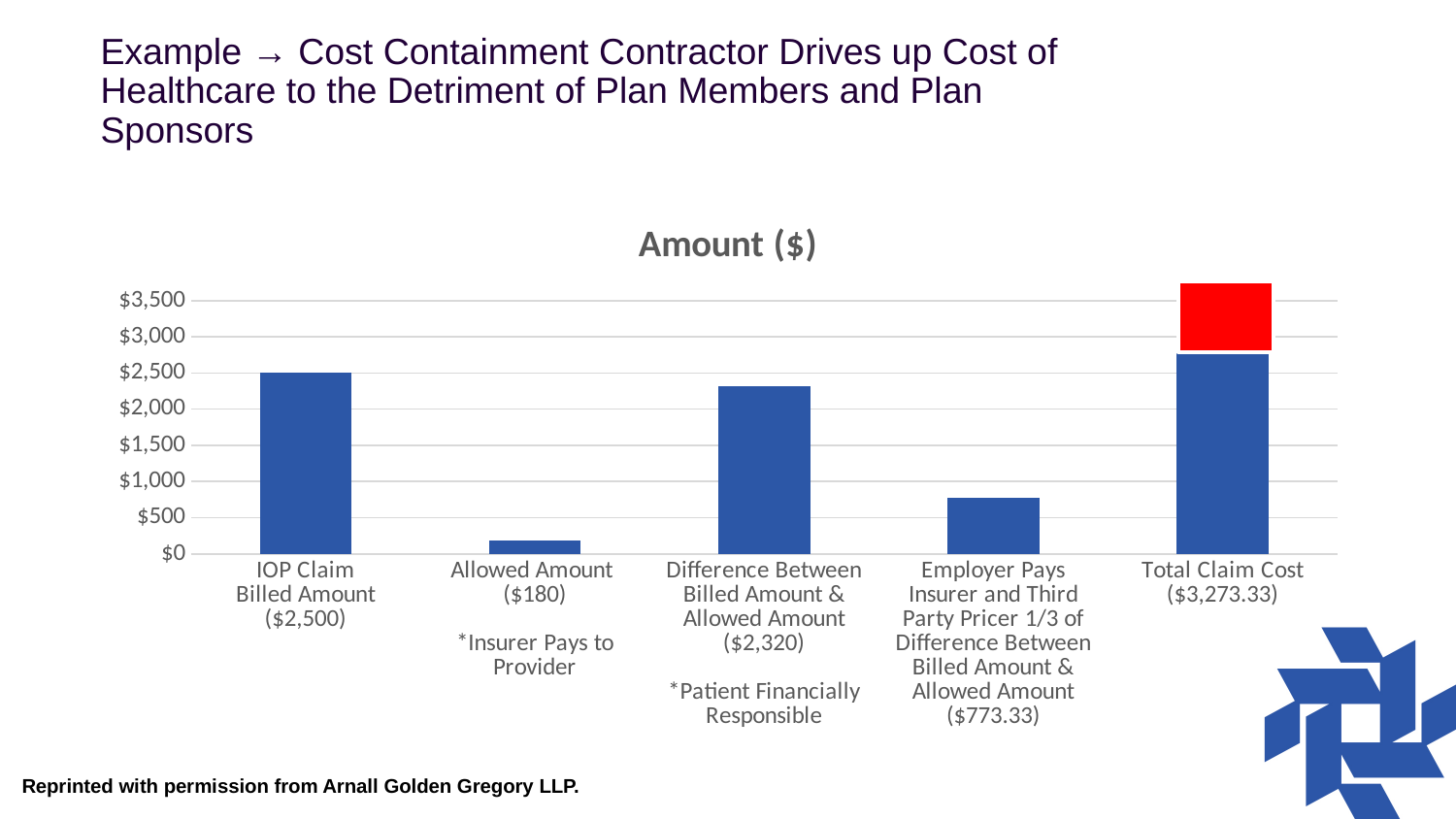
How many categories are shown on the x axis? 5 What is the value for Allowed Amount? $180 What is the value for IOP Claim Billed Amount? $2,500 Which category has the lowest value? Allowed Amount What is the title of the chart? Amount ($) Which category has the highest value? Total Claim Cost What is the difference between IOP Claim Billed Amount and Allowed Amount? $2,320 What is the value for Employer Pays Insurer and Third Party Pricer 1/3 of Difference Between Billed Amount & Allowed Amount? $773.33 What kind of chart is shown on the slide? bar chart What is the value for Total Claim Cost? $3,273.33 Is the value for Total Claim Cost greater or less than $3,000? greater Which is larger, the Difference Between Billed Amount & Allowed Amount or the Employer Pays amount? Difference Between Billed Amount & Allowed Amount